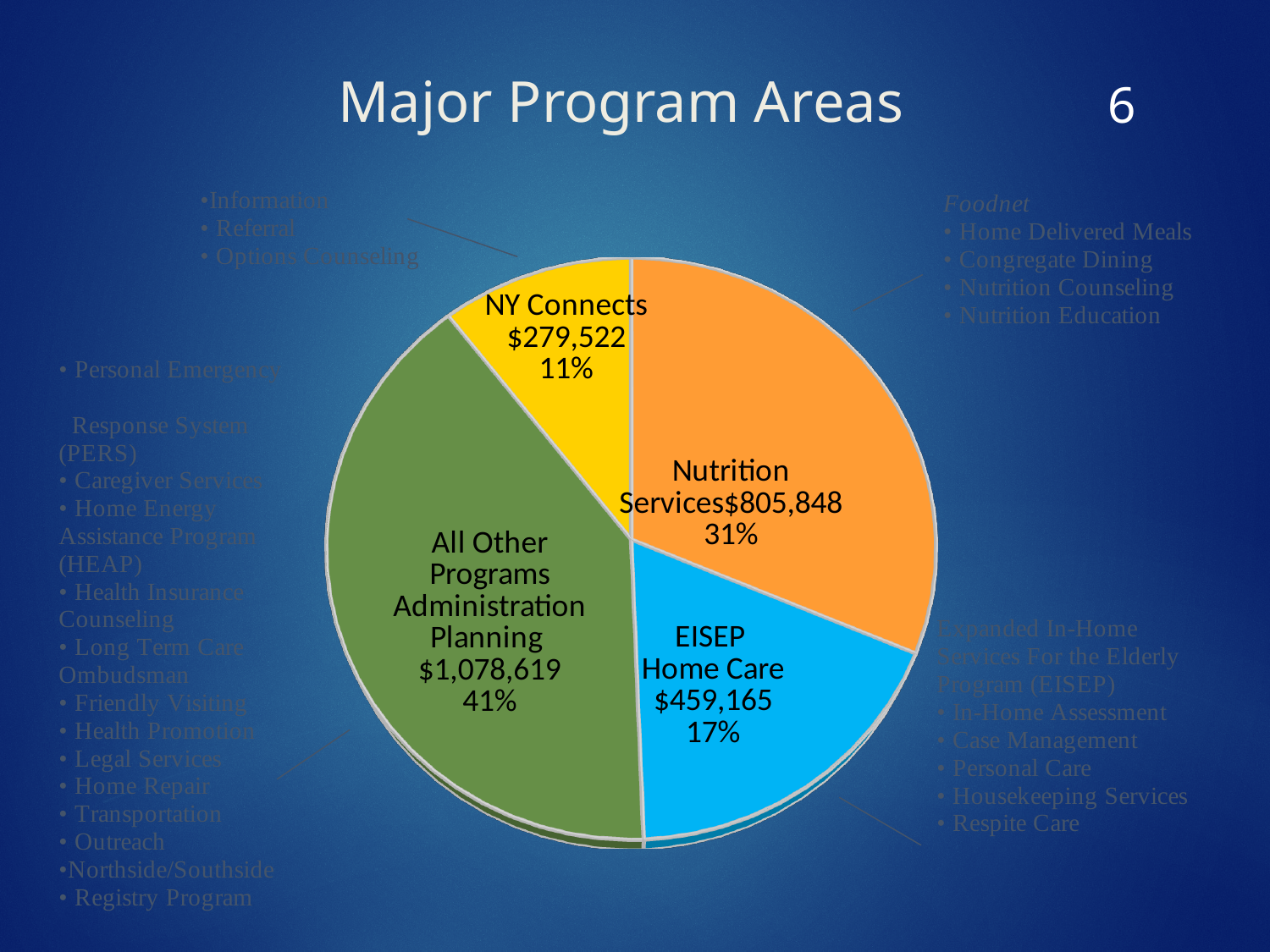
What share of the pie does Nutrition Services represent? 31% What is the dollar value for NY Connects? $279,522 Which is larger, EISEP Home Care or NY Connects? EISEP Home Care Which slice is the smallest? NY Connects How many slices does the pie chart have? 4 What is the dollar value for All Other Programs Administration Planning? $1,078,619 What is the dollar value for Nutrition Services? $805,848 What share of the pie does NY Connects represent? 11% Which slice is the largest? All Other Programs Administration Planning What is the difference in dollars between Nutrition Services and EISEP Home Care? $346,683 What is the dollar value for EISEP Home Care? $459,165 What kind of chart is shown on the slide? pie chart